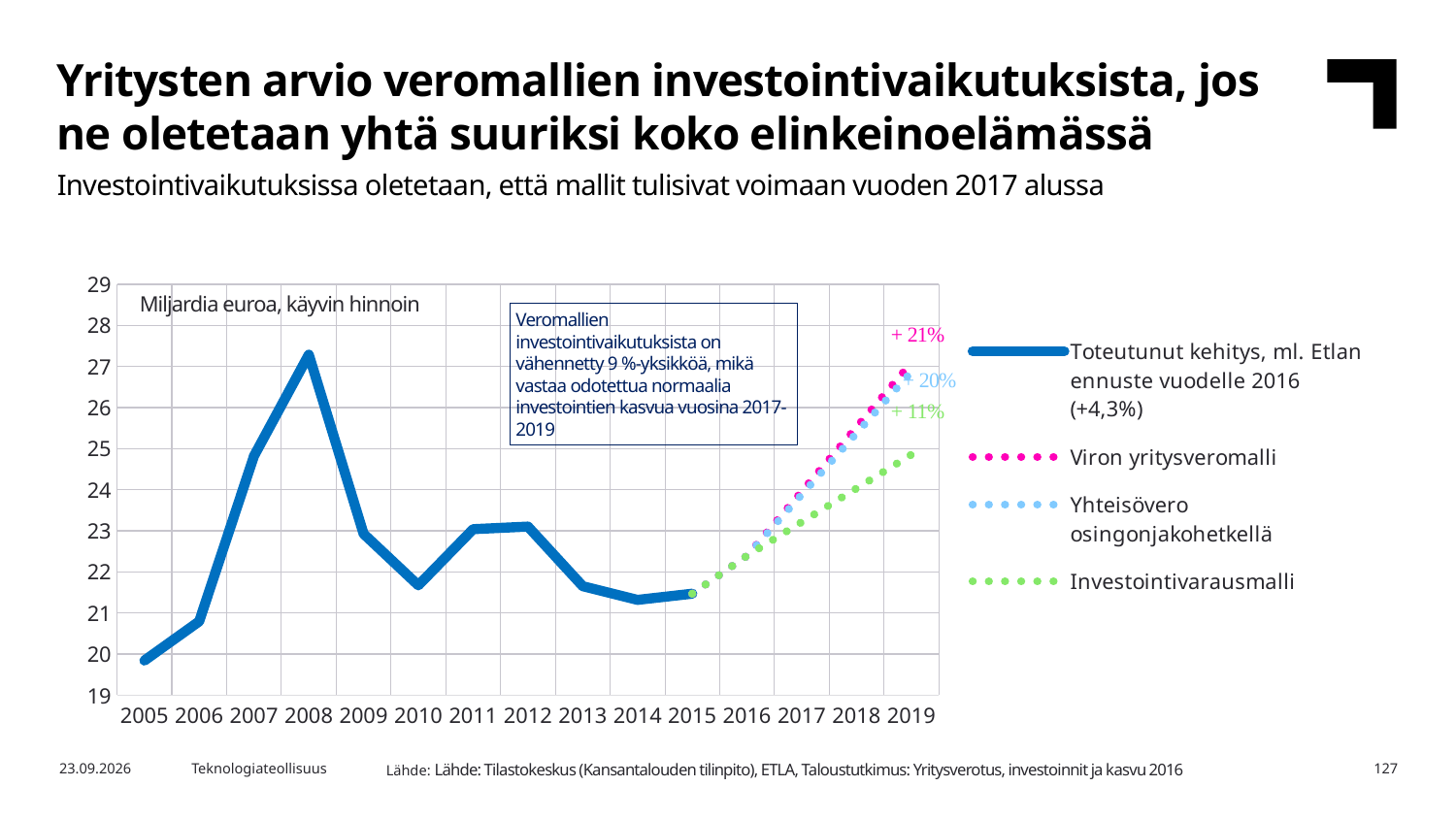
In which year does the Toteutunut kehitys series have its lowest value? 2005 What percentage growth is labelled for the Investointivarausmalli series in 2019? +11% Does the Toteutunut kehitys series rise or fall from 2008 to 2010? fall Is the value for Toteutunut kehitys in 2008 greater or less than 27? greater Is the value for Toteutunut kehitys in 2005 greater or less than 20? less In which year does the Toteutunut kehitys series reach its highest value? 2008 Which is larger, the Toteutunut kehitys value in 2008 or in 2013? 2008 What kind of chart is shown on the slide? line chart Which projected model series ends lowest in 2019? Investointivarausmalli How many series does the chart legend list? 4 Is the value for Toteutunut kehitys in 2014 greater or less than 22? less How many years are shown on the x axis of the chart? 15